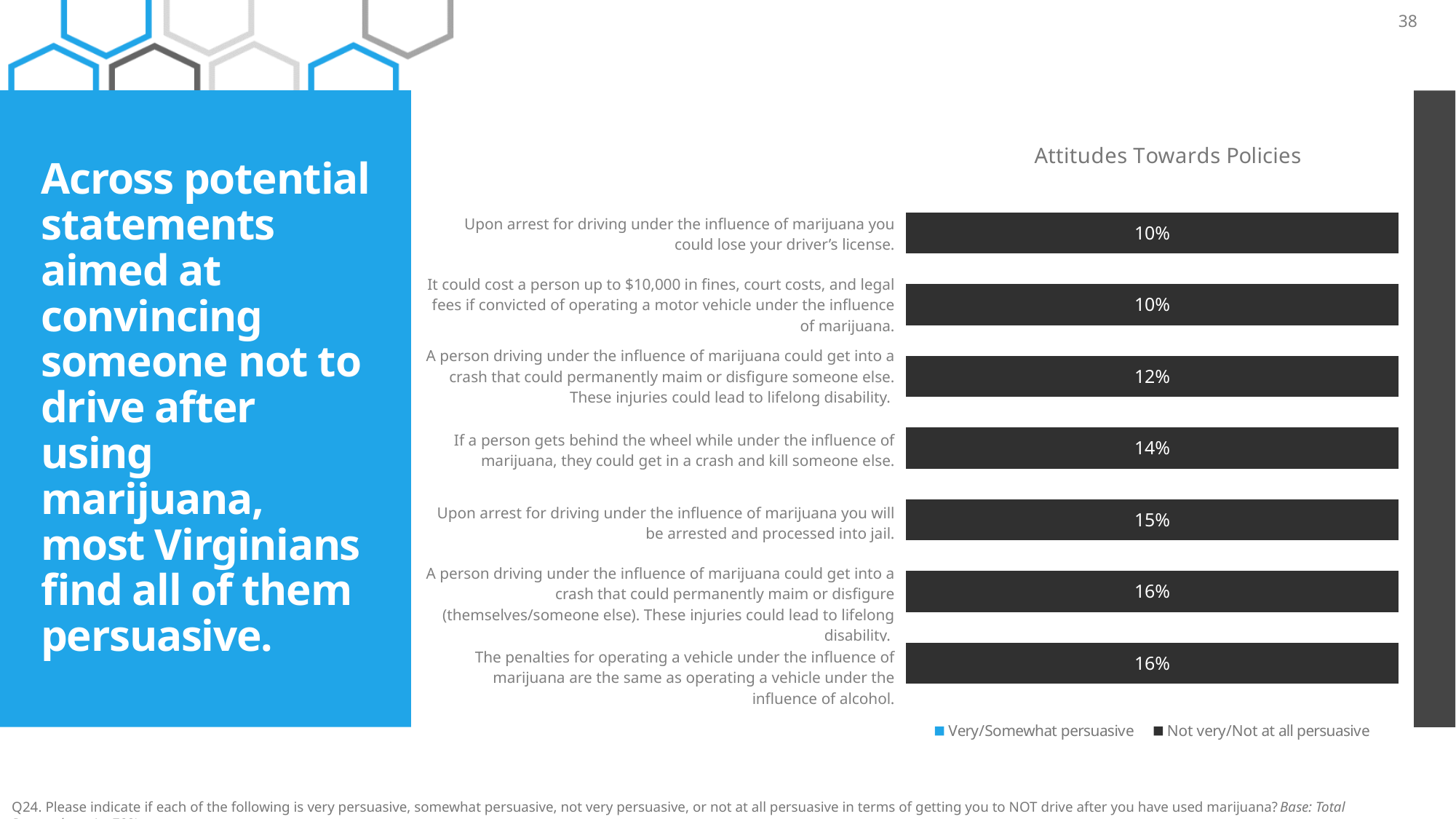
What percentage is labelled on the bar for 'Upon arrest for driving under the influence of marijuana you will be arrested and processed into jail'? 15% What percentage is labelled on the bar for 'If a person gets behind the wheel while under the influence of marijuana, they could get in a crash and kill someone else'? 14% How many series does the chart legend list? 2 What is the difference between the labelled value for the statement about penalties being the same as alcohol (16%) and the statement about losing your driver's license (10%)? 6 percentage points What type of chart is shown on the slide? bar chart Which has the larger labelled value: the statement about being arrested and processed into jail, or the statement about $10,000 in fines, court costs, and legal fees? the statement about being arrested and processed into jail What percentage is labelled on the bar for the statement about a crash that could permanently maim or disfigure someone else? 12% What percentage is labelled on the bar for 'The penalties for operating a vehicle under the influence of marijuana are the same as operating a vehicle under the influence of alcohol'? 16% How many statements (categories) are plotted in the chart? 7 What percentage is labelled on the bar for 'Upon arrest for driving under the influence of marijuana you could lose your driver's license'? 10% Which legend entry is shown with a dark (black) marker? Not very/Not at all persuasive What is the title of the chart? Attitudes Towards Policies